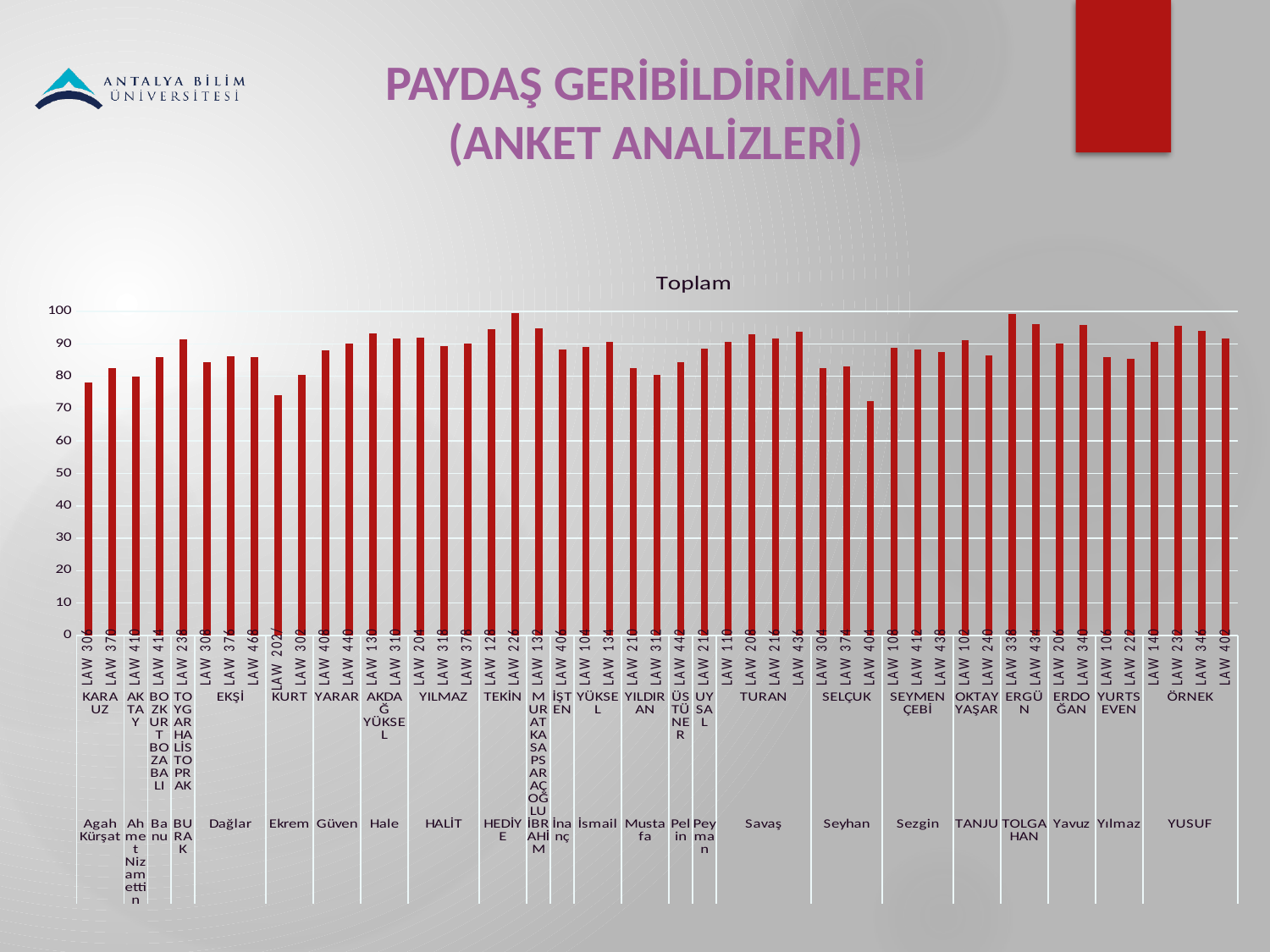
Is the value for LAW 202 (Ekrem KURT) greater or less than 80? less Is the value for LAW 226 (TEKİN) greater or less than 90? greater What is the highest value shown on the vertical axis of the chart? 100 Is the value for LAW 130 (Hale AKDAĞ YÜKSEL) greater or less than 90? greater What is the title of the chart? Toplam Which is larger, the value for LAW 404 (Seyhan SELÇUK) or the value for LAW 130 (Hale AKDAĞ YÜKSEL)? LAW 130 (Hale AKDAĞ YÜKSEL) What colour are the bars in the chart? red What kind of chart is shown on the slide? bar chart Which is larger, the value for LAW 202 (Ekrem KURT) or the value for LAW 226 (TEKİN)? LAW 226 (TEKİN)